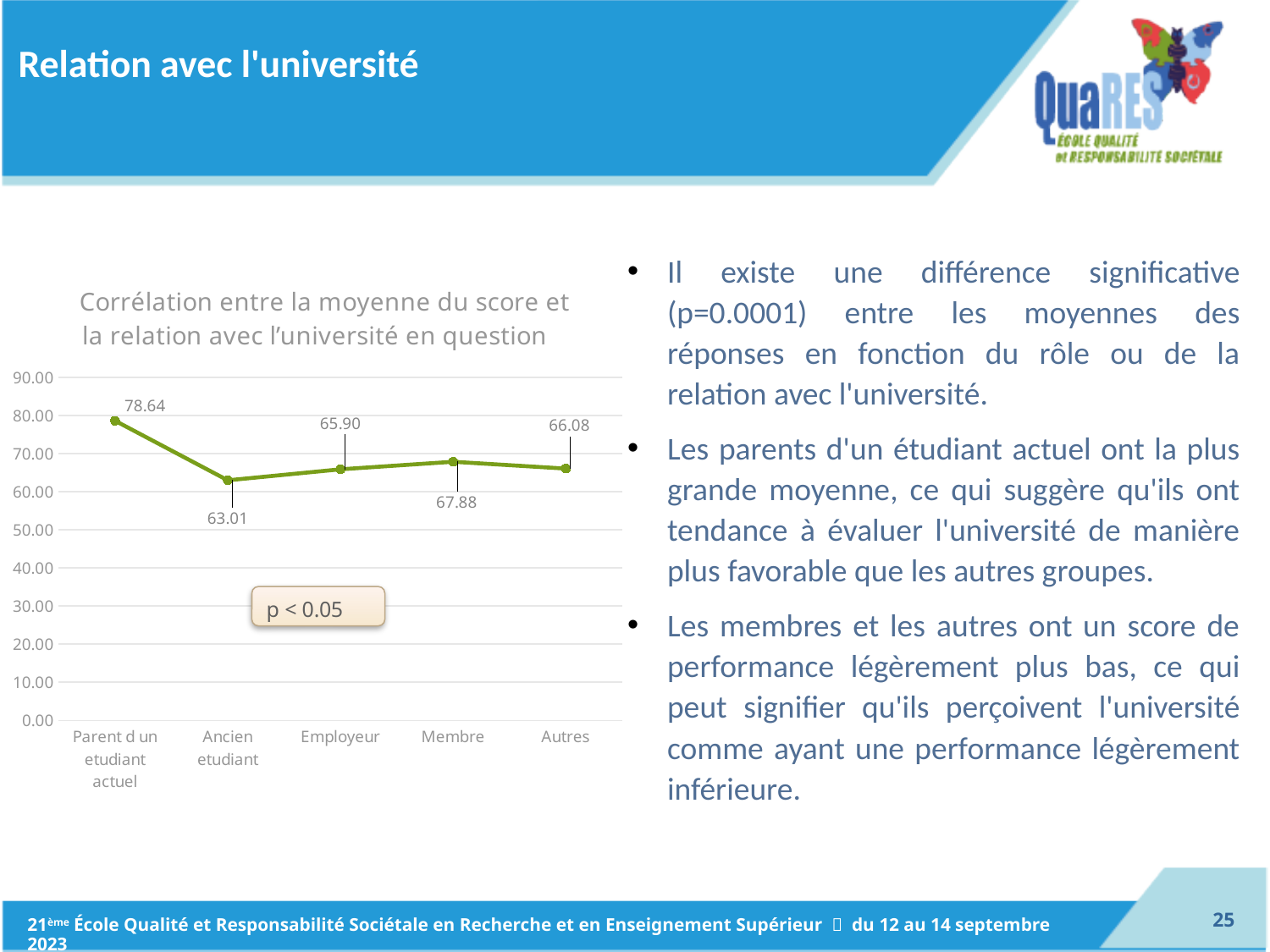
Which is larger, the value for Membre or the value for Employeur? Membre What is the value for Parent d un etudiant actuel? 78.64 How many categories are plotted on the x axis? 5 What is the difference between the values for Parent d un etudiant actuel and Ancien etudiant? 15.63 What is the value for Employeur? 65.90 What is the value for Membre? 67.88 What is the title of the chart? Corrélation entre la moyenne du score et la relation avec l'université en question Which category has the lowest value? Ancien etudiant Which category has the highest value? Parent d un etudiant actuel What is the value for Autres? 66.08 What kind of chart is shown on the slide? Line chart What is the value for Ancien etudiant? 63.01